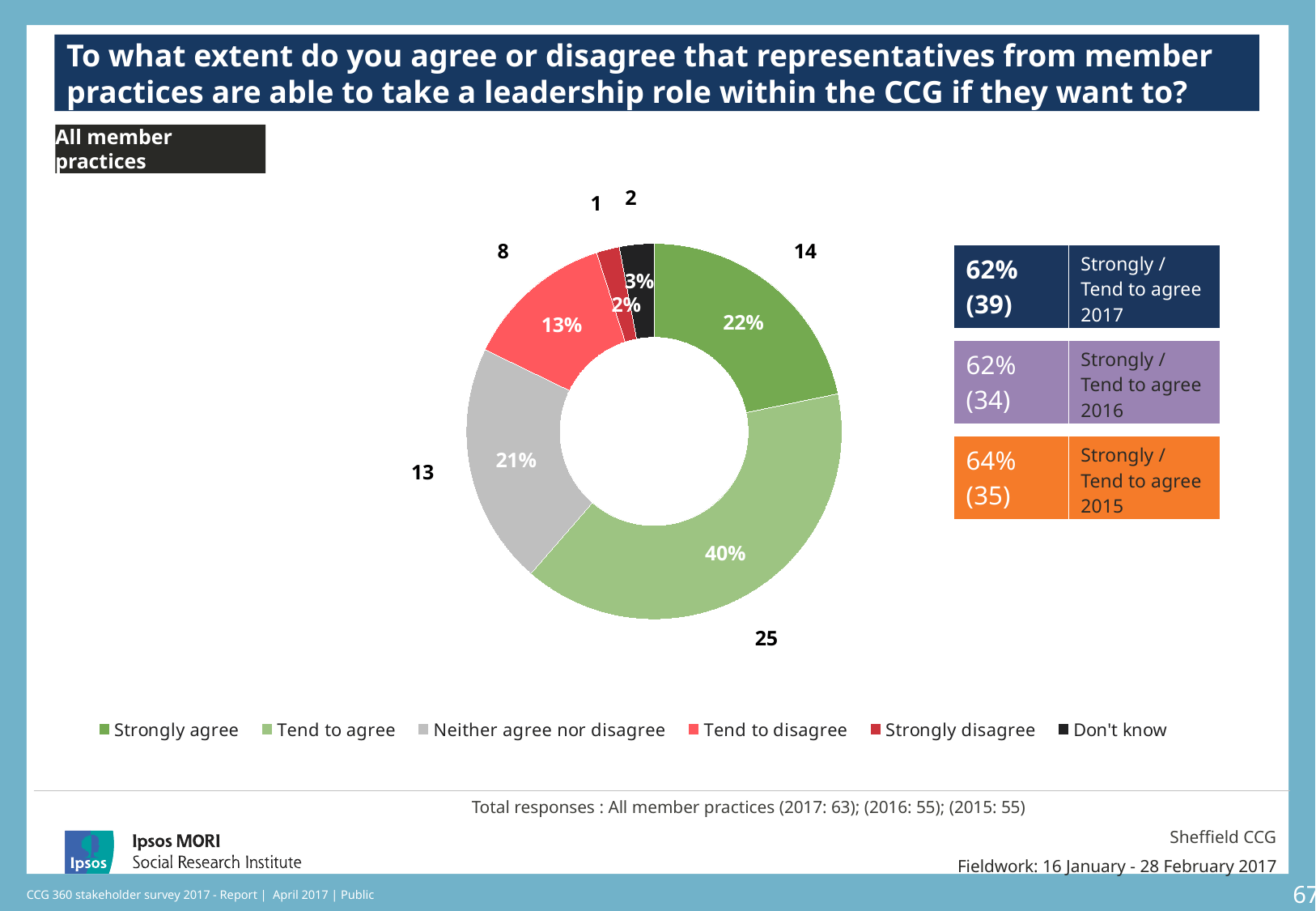
Which response category has the smallest share of the chart? Strongly disagree How many response categories does the legend list? 6 Which response category has the largest share of the chart? Tend to agree What percentage of respondents answered 'Neither agree nor disagree'? 21% What type of chart is shown on the slide? Donut (pie) chart What was the combined 'Strongly / Tend to agree' percentage in 2016? 62% What percentage of respondents said they 'Tend to agree'? 40% What percentage of respondents said they 'Tend to disagree'? 13% How many respondents answered 'Don't know'? 2 Which is larger: the share for 'Neither agree nor disagree' or the share for 'Tend to disagree'? Neither agree nor disagree What is the difference in percentage points between 'Tend to agree' and 'Strongly agree'? 18 What percentage of respondents said they 'Strongly agree'? 22%